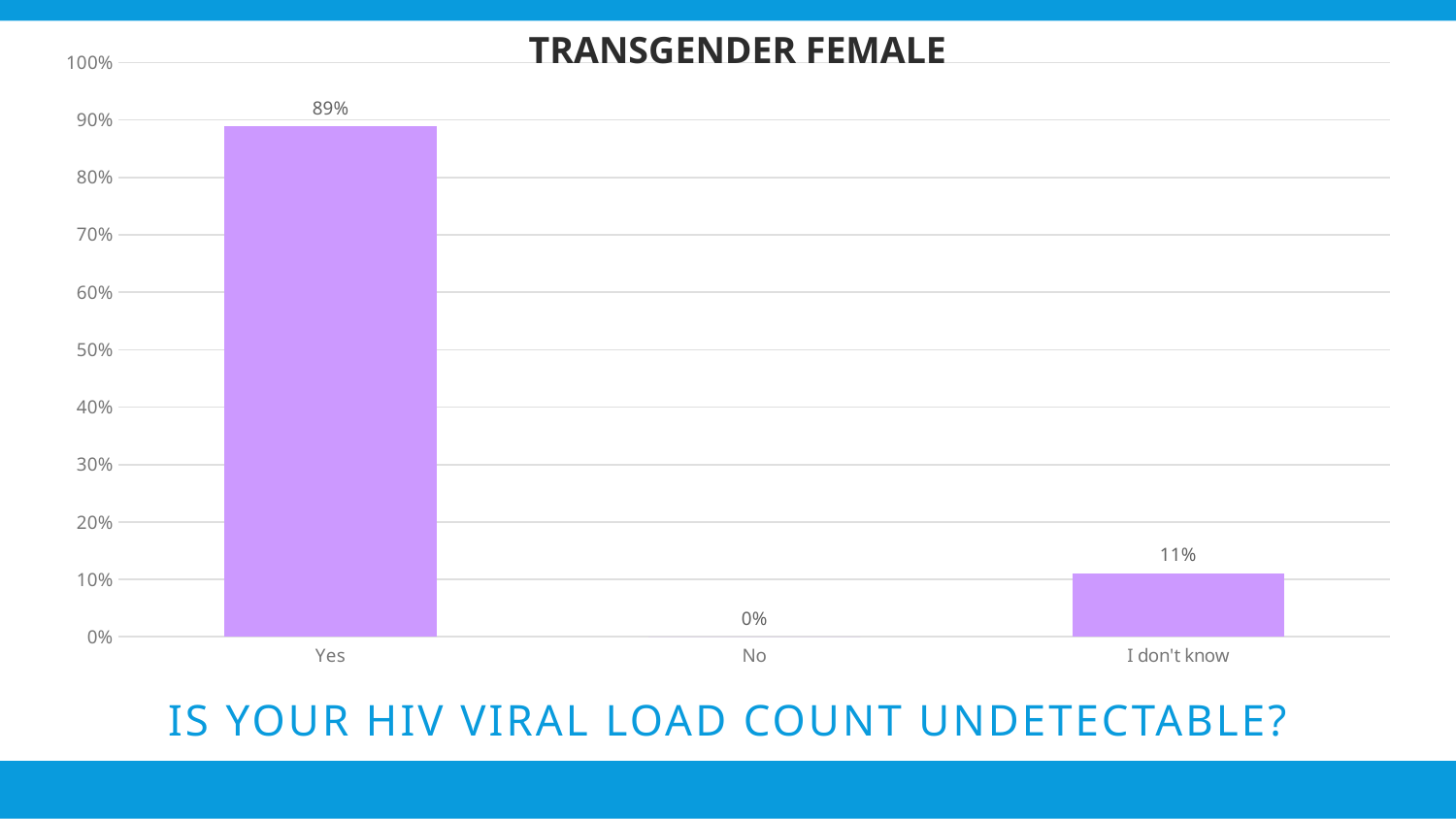
What is the value for "No"? 0% Which category has the highest value? Yes Is the value for "I don't know" greater or less than 20%? less Is the value for "Yes" greater or less than 80%? greater Which is larger, the value for "I don't know" or the value for "No"? I don't know Which category has the lowest value? No What is the difference between the values for "Yes" and "I don't know"? 78% What is the title of the chart? TRANSGENDER FEMALE What is the value for "Yes"? 89% What is the value for "I don't know"? 11% What kind of chart is shown on the slide? bar chart How many categories are shown on the x axis? 3